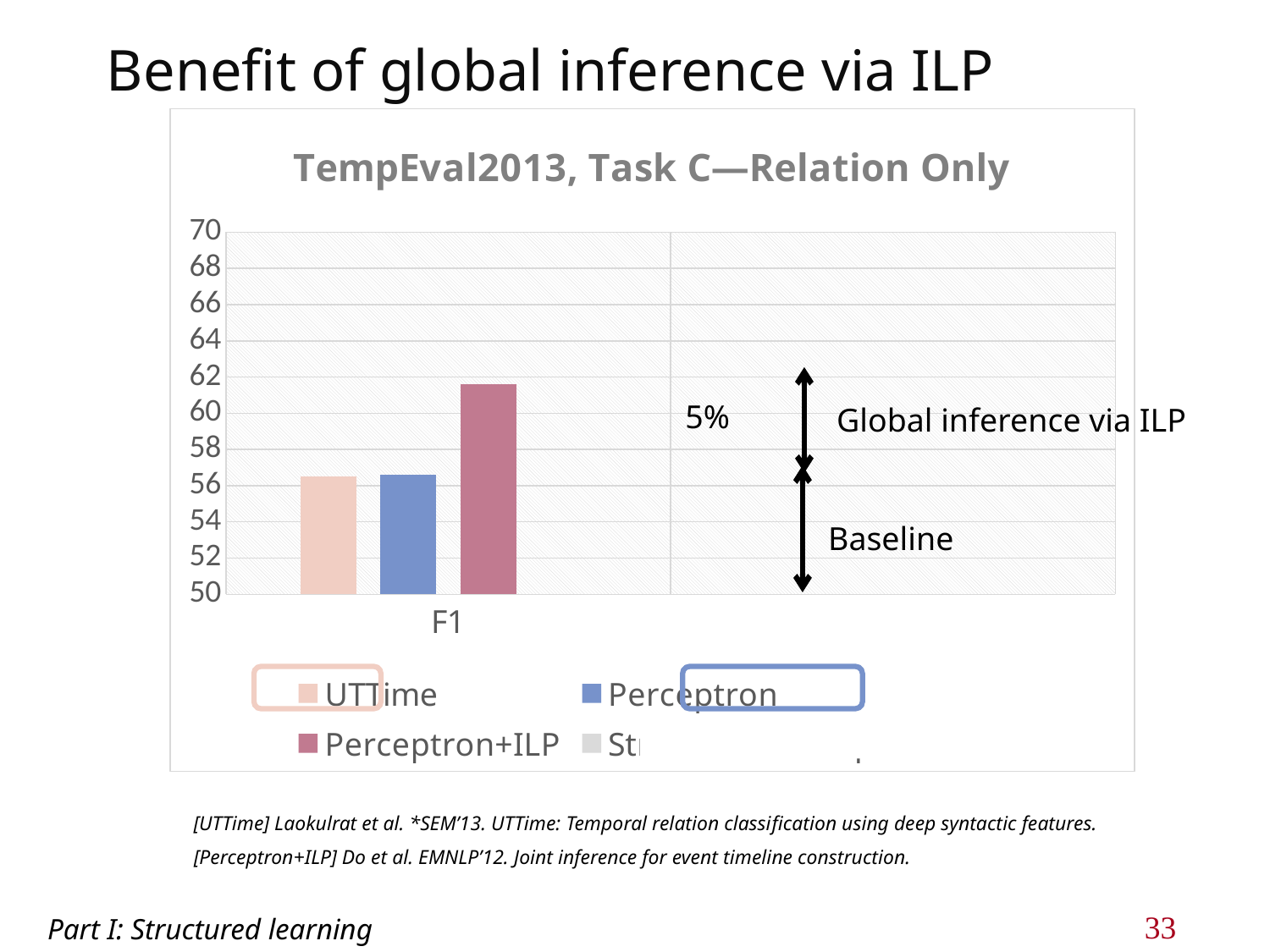
Is the value for Perceptron+ILP greater or less than 60? greater What kind of chart is shown on the slide? bar chart Is the value for Perceptron+ILP greater or less than 64? less Which is larger, the value for Perceptron+ILP or the value for UTTime? Perceptron+ILP What is the label of the category on the x axis? F1 Is the value for Perceptron greater or less than 58? less Which is larger, the value for Perceptron+ILP or the value for Perceptron? Perceptron+ILP How many categories are shown on the x axis of the chart? 1 Which series has the highest bar in the chart? Perceptron+ILP How many series does the chart legend list? 4 What is the title of the chart? TempEval2013, Task C—Relation Only